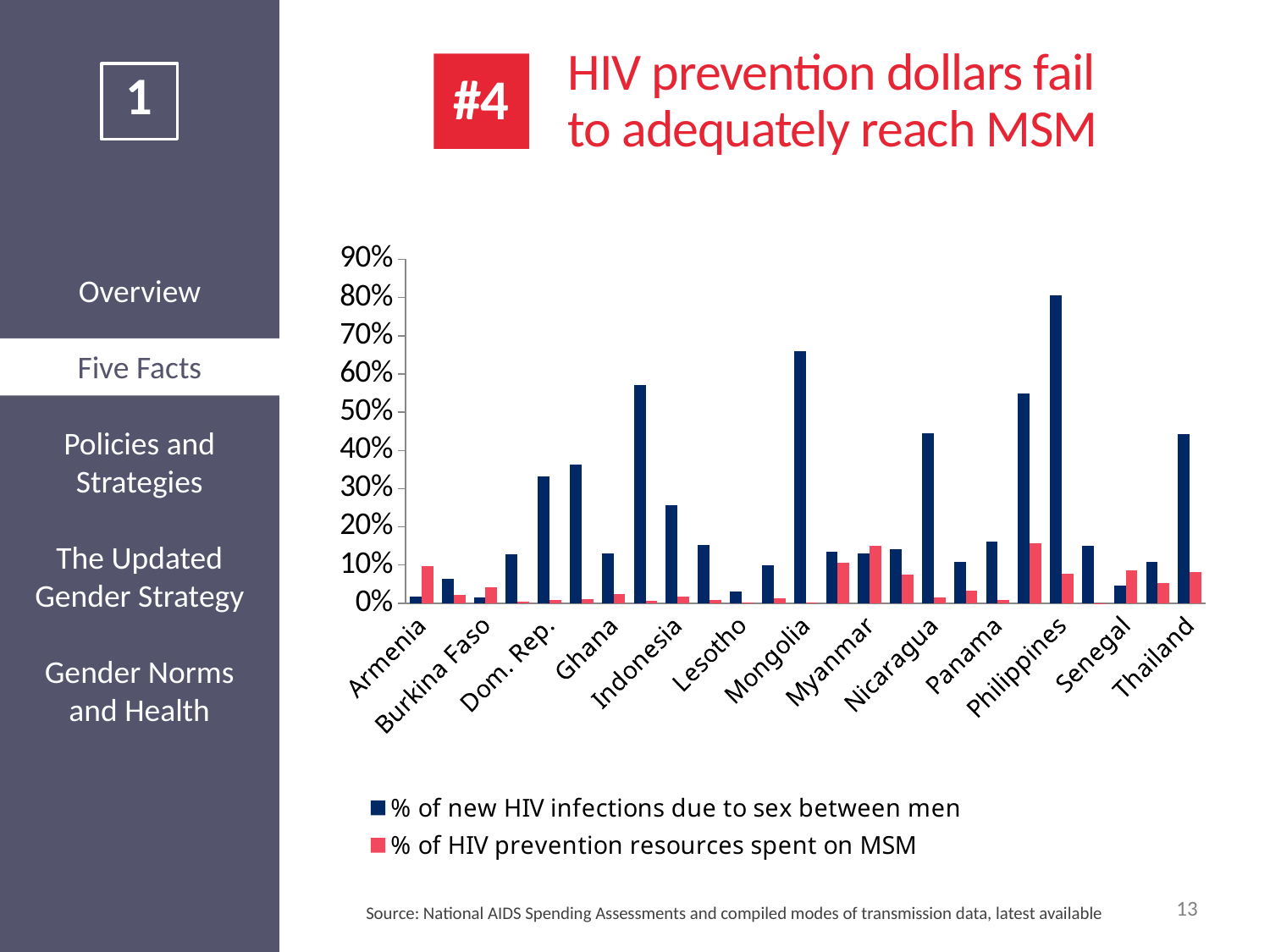
Is the value for Thailand for % of new HIV infections due to sex between men greater or less than 30%? greater Is the value for Mongolia for % of new HIV infections due to sex between men greater or less than 50%? greater Which is larger for % of new HIV infections due to sex between men: Philippines or Lesotho? Philippines What is the title of the slide containing the chart? HIV prevention dollars fail to adequately reach MSM Which series is shown in dark blue in the legend? % of new HIV infections due to sex between men Is the value for Armenia for % of new HIV infections due to sex between men greater or less than 10%? less Which country has the highest value for % of new HIV infections due to sex between men? Philippines For Armenia, which is larger: % of new HIV infections due to sex between men or % of HIV prevention resources spent on MSM? % of HIV prevention resources spent on MSM What kind of chart is shown on the slide? bar chart How many series does the legend list? 2